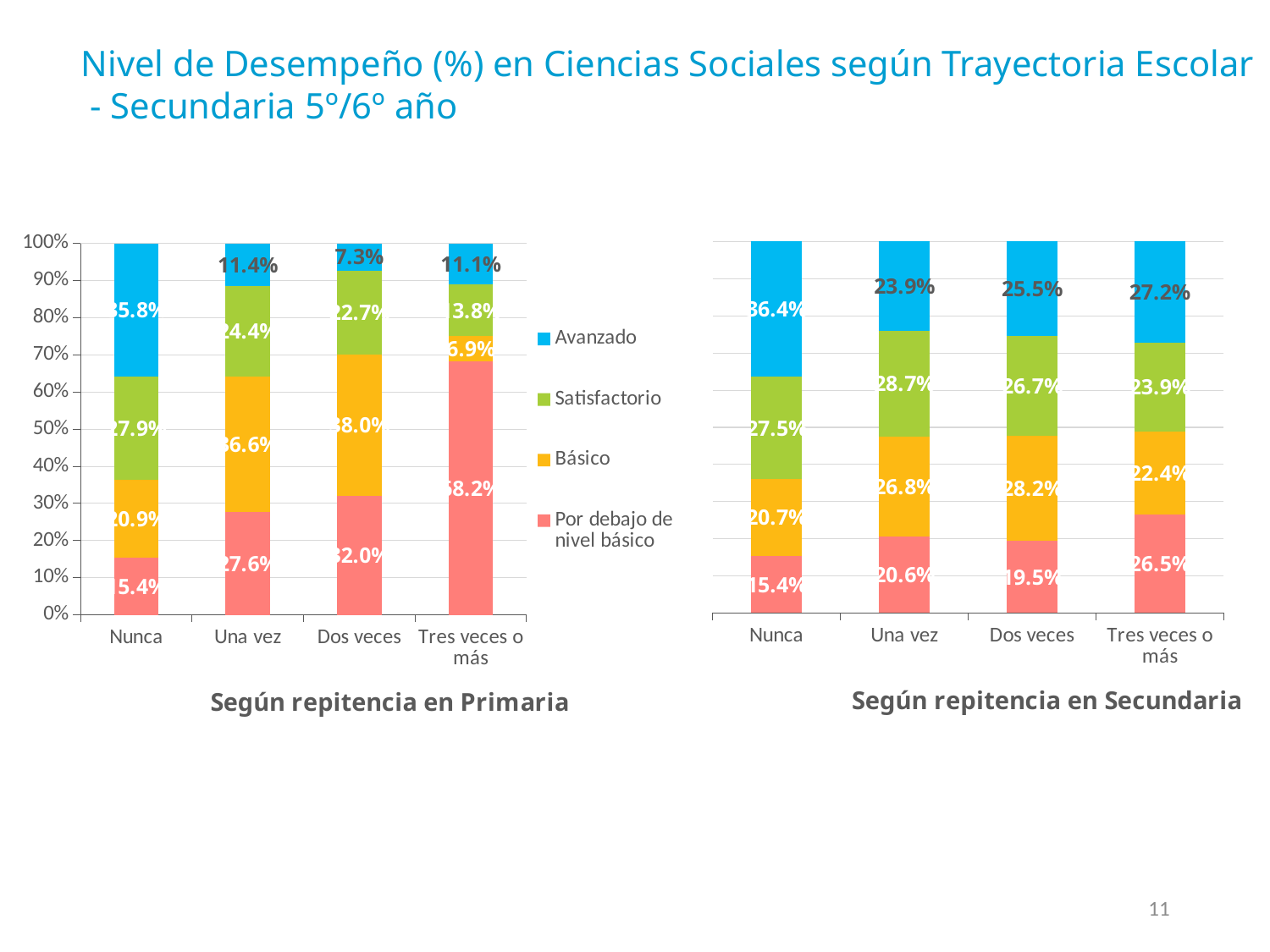
In the 'Según repitencia en Secundaria' chart, what is the difference between the Básico values for Dos veces and Tres veces o más? 5.8% What kind of chart is 'Según repitencia en Secundaria'? Stacked bar chart In the 'Según repitencia en Secundaria' chart, what is the Por debajo de nivel básico value for Dos veces? 19.5% In the 'Según repitencia en Primaria' chart, what is the Avanzado value for Una vez? 11.4% In the 'Según repitencia en Primaria' chart, which category has the lowest Avanzado value? Dos veces In the 'Según repitencia en Secundaria' chart, which category has the highest Avanzado value? Nunca How many series does the legend list? 4 In the 'Según repitencia en Secundaria' chart, is the Por debajo de nivel básico value for Tres veces o más greater or less than 20%? greater In the 'Según repitencia en Primaria' chart, which is larger: the Básico value for Una vez or the Básico value for Dos veces? Dos veces How many categories are shown on the x axis of the 'Según repitencia en Primaria' chart? 4 In the 'Según repitencia en Primaria' chart, what is the Básico value for Dos veces? 38.0% In the 'Según repitencia en Secundaria' chart, what is the Avanzado value for Tres veces o más? 27.2%